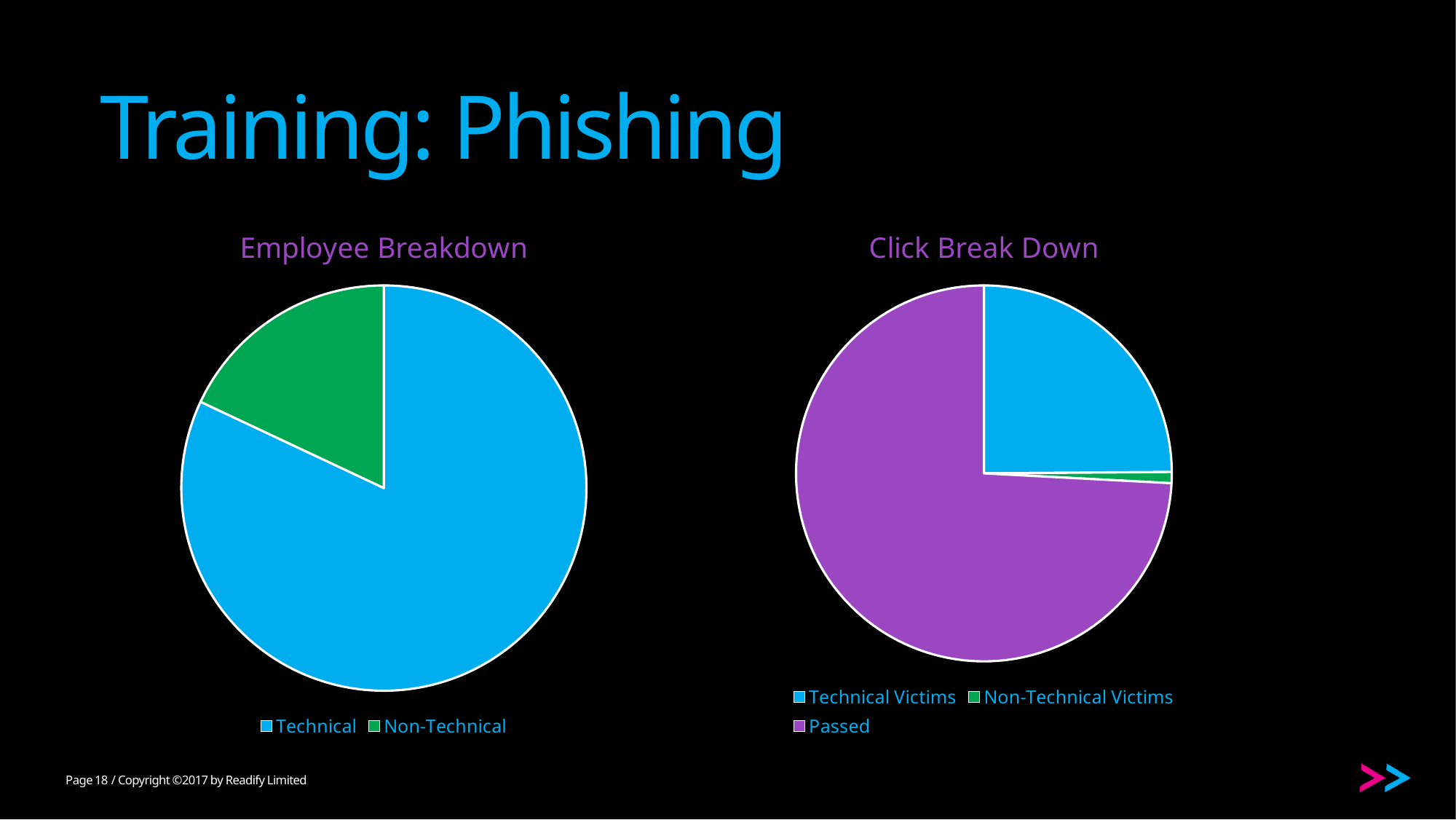
In the "Employee Breakdown" chart, which category has the smallest slice? Non-Technical In the "Click Break Down" chart, which is larger: Passed or Technical Victims? Passed How many slices does the "Employee Breakdown" pie chart have? 2 What kind of chart is the "Employee Breakdown" chart? Pie chart In the "Click Break Down" chart, which category has the largest slice? Passed In the "Employee Breakdown" chart, which category has the largest slice? Technical How many entries does the legend of the "Click Break Down" chart list? 3 In the "Click Break Down" chart, which category has the smallest slice? Non-Technical Victims In the "Click Break Down" chart, which is larger: Technical Victims or Non-Technical Victims? Technical Victims How many slices does the "Click Break Down" pie chart have? 3 In the "Click Break Down" chart, what colour is the Passed slice? Purple What kind of chart is the "Click Break Down" chart? Pie chart